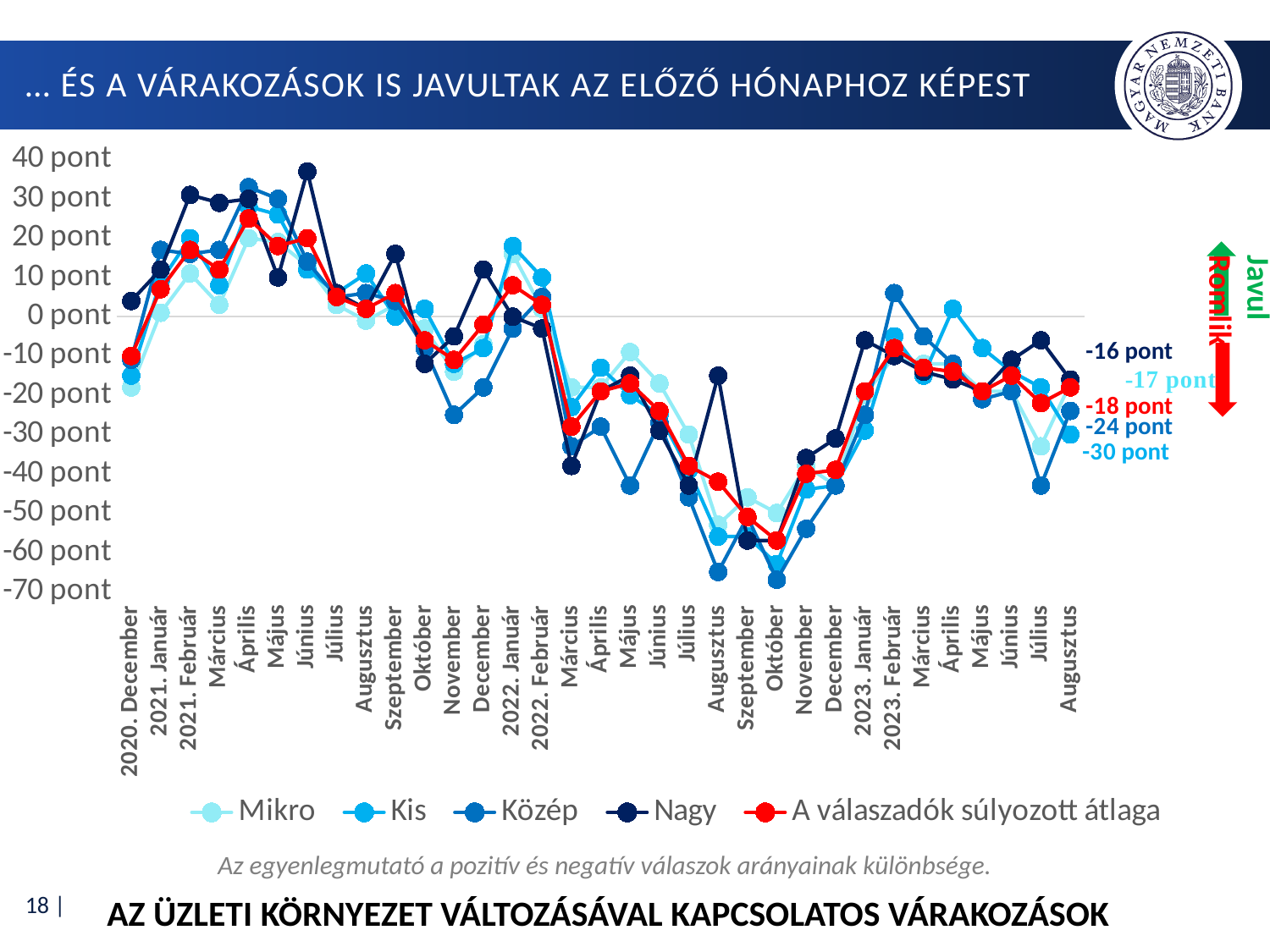
Which series is drawn in red? A válaszadók súlyozott átlaga What kind of chart is shown on the slide? line chart How many months (categories) are shown on the x axis? 33 Is the value of 'A válaszadók súlyozott átlaga' at 2022 Október greater or less than -50 pont? less How many series does the legend list? 5 Does 'A válaszadók súlyozott átlaga' rise or fall between 2022 Február and 2022 Október? fall What is the highest value shown on the y axis? 40 pont What is the value of the Nagy series at 2023 Augusztus? -16 pont Is the value of the Nagy series at 2021 Június greater or less than 30 pont? greater What is the value of 'A válaszadók súlyozott átlaga' at 2023 Augusztus? -18 pont At 2023 Augusztus, which is larger: the Nagy series or 'A válaszadók súlyozott átlaga'? Nagy What is the difference between the Nagy value (-16 pont) and 'A válaszadók súlyozott átlaga' (-18 pont) at 2023 Augusztus? 2 pont